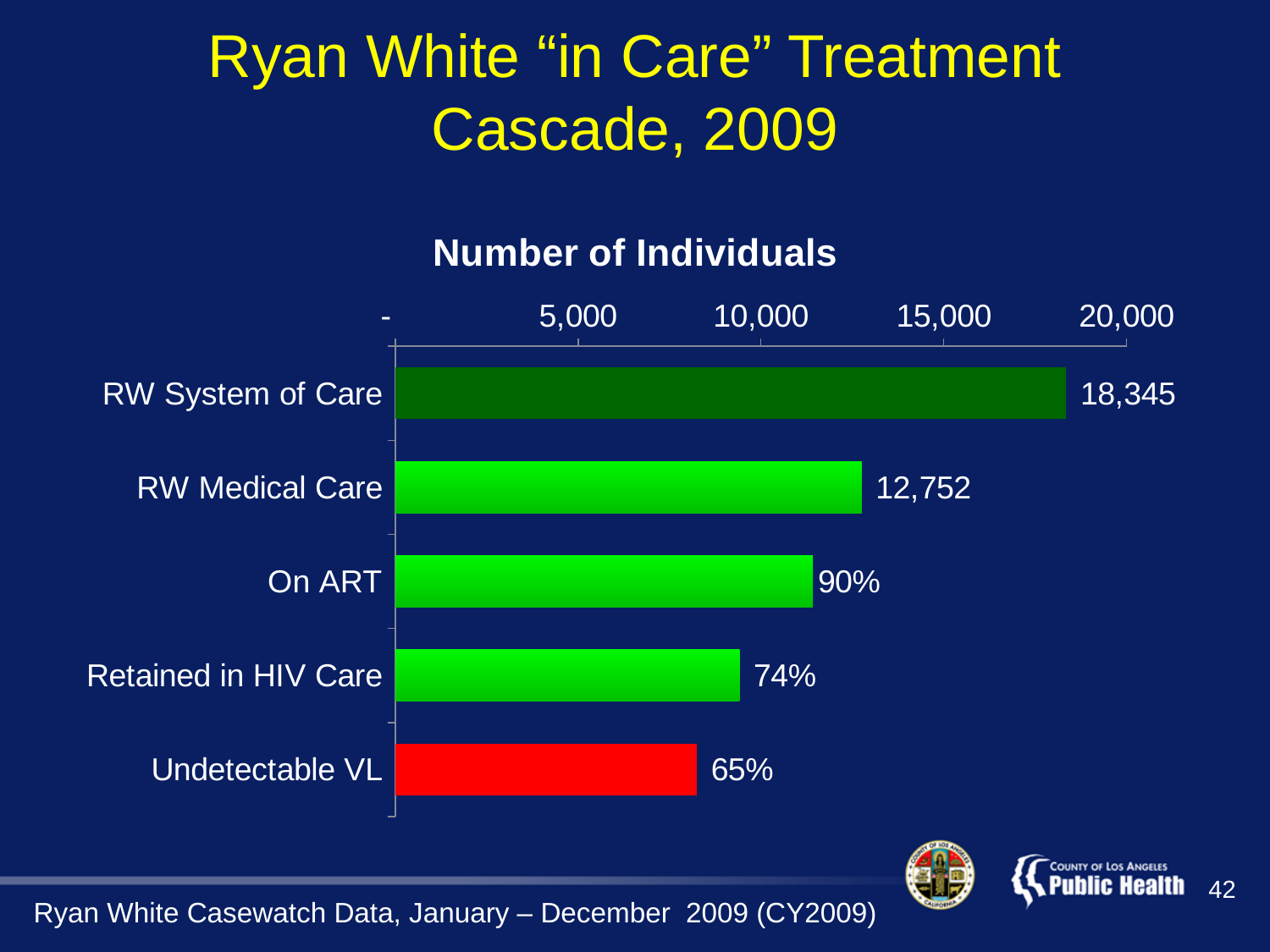
Is the bar for On ART greater or less than 10,000 on the axis? greater How many categories are shown in the chart? 5 What value is shown for RW Medical Care? 12,752 Which category has the longest bar? RW System of Care What label is shown on the Retained in HIV Care bar? 74% Which category has the shortest bar? Undetectable VL Is the bar for Retained in HIV Care greater or less than 10,000 on the axis? less What kind of chart is shown on the slide? Bar chart What is the difference between the RW System of Care value and the RW Medical Care value? 5,593 What value is shown for RW System of Care? 18,345 What label is shown on the Undetectable VL bar? 65% What label is shown on the On ART bar? 90%